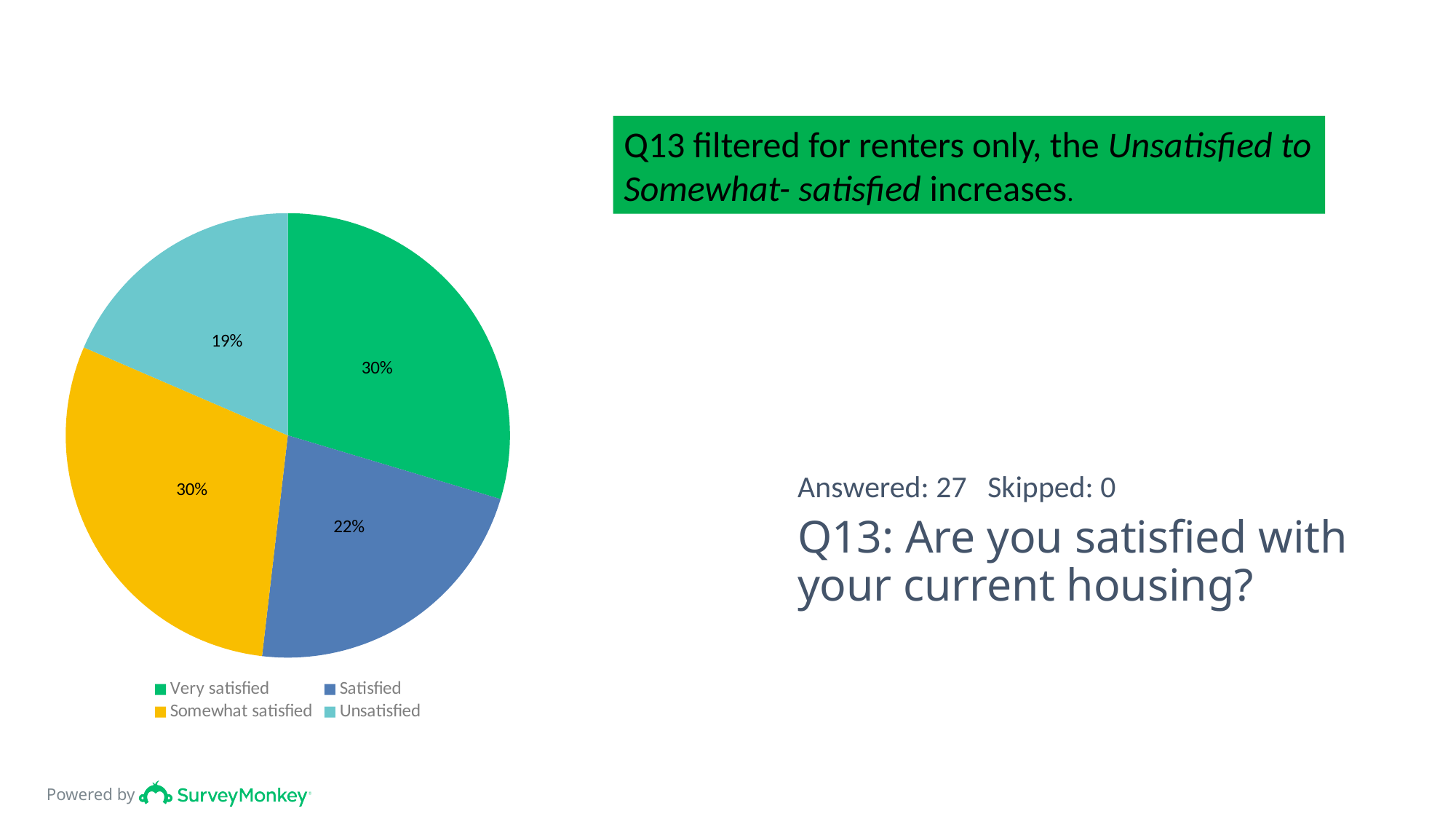
How many entries does the legend list? 4 What kind of chart is shown on the slide? pie chart What is the difference in percentage points between the Somewhat satisfied and Satisfied slices? 8 What is the difference in percentage points between the Very satisfied and Unsatisfied slices? 11 What colour is the Somewhat satisfied slice in the pie chart? yellow What share of the pie is labelled Unsatisfied? 19% What share of the pie is labelled Somewhat satisfied? 30% What share of the pie is labelled Satisfied? 22% What share of the pie is labelled Very satisfied? 30% Which slice is larger, Satisfied or Somewhat satisfied? Somewhat satisfied Which category has the smallest slice of the pie? Unsatisfied How many slices does the pie chart have? 4